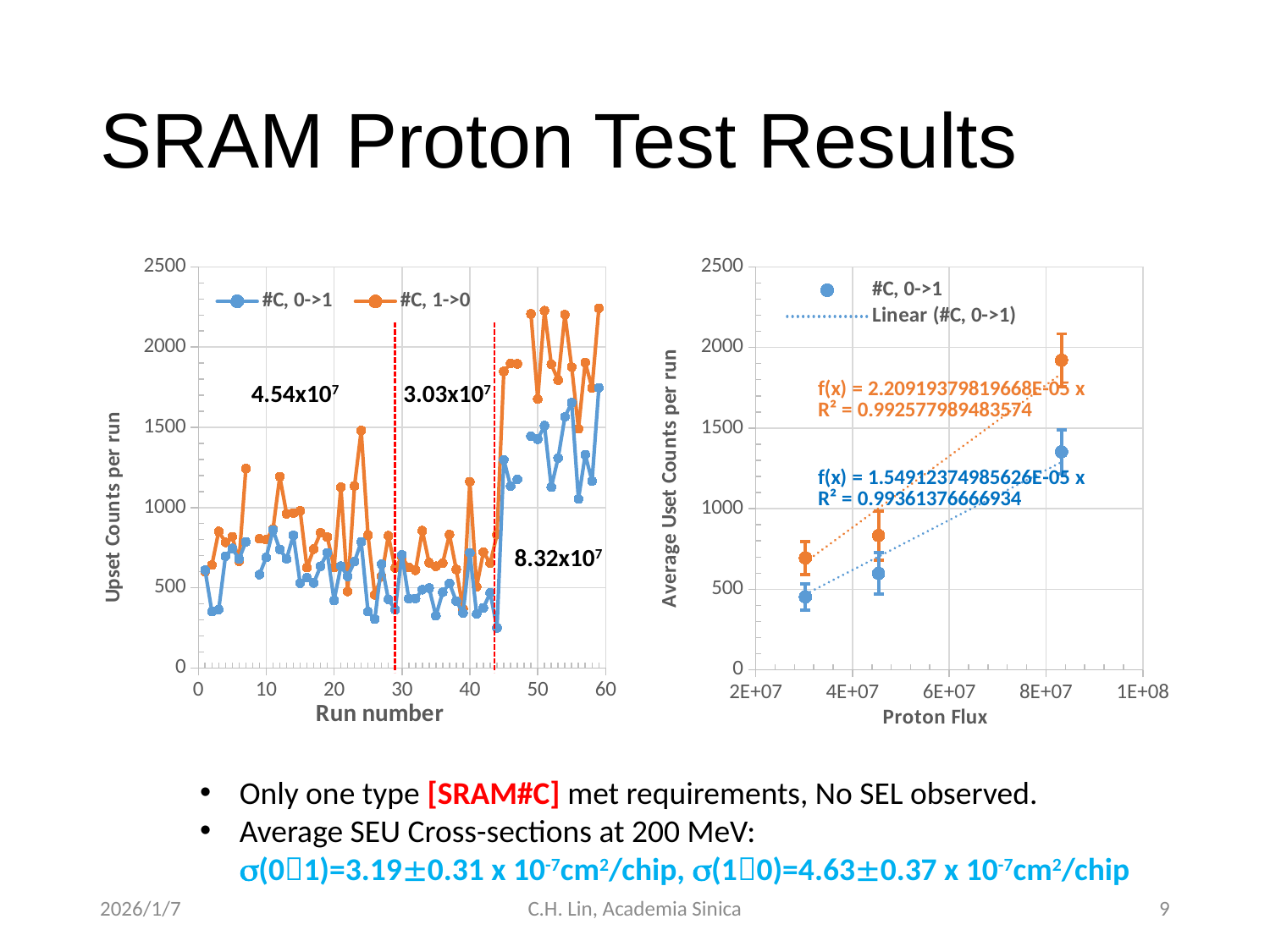
In the right chart, do the average upset counts rise or fall as proton flux increases? rise In the right chart, is the blue #C, 0->1 value at the highest proton flux (around 8E+07) greater or less than 1000? greater What are the two series named in the legend of the left chart? #C, 0->1 and #C, 1->0 In the right chart, what is the R² value printed for the orange linear fit? R² = 0.992577989483574 In the right chart, what is the R² value printed for the #C, 0->1 linear fit (blue)? R² = 0.99361376666934 In the left chart, which series has the larger value at run 50: #C, 0->1 or #C, 1->0? #C, 1->0 In the right chart, what is the fitted equation printed for the #C, 0->1 series (blue)? f(x) = 1.54912374985626E-05 x What is the x-axis label of the right chart? Proton Flux How many series does the legend of the left chart list? 2 In the right chart, is the orange value at the highest proton flux (around 8E+07) greater or less than 1500? greater How many entries does the legend of the right chart list? 2 What kind of chart is the left chart (Upset Counts per run vs Run number)? line chart